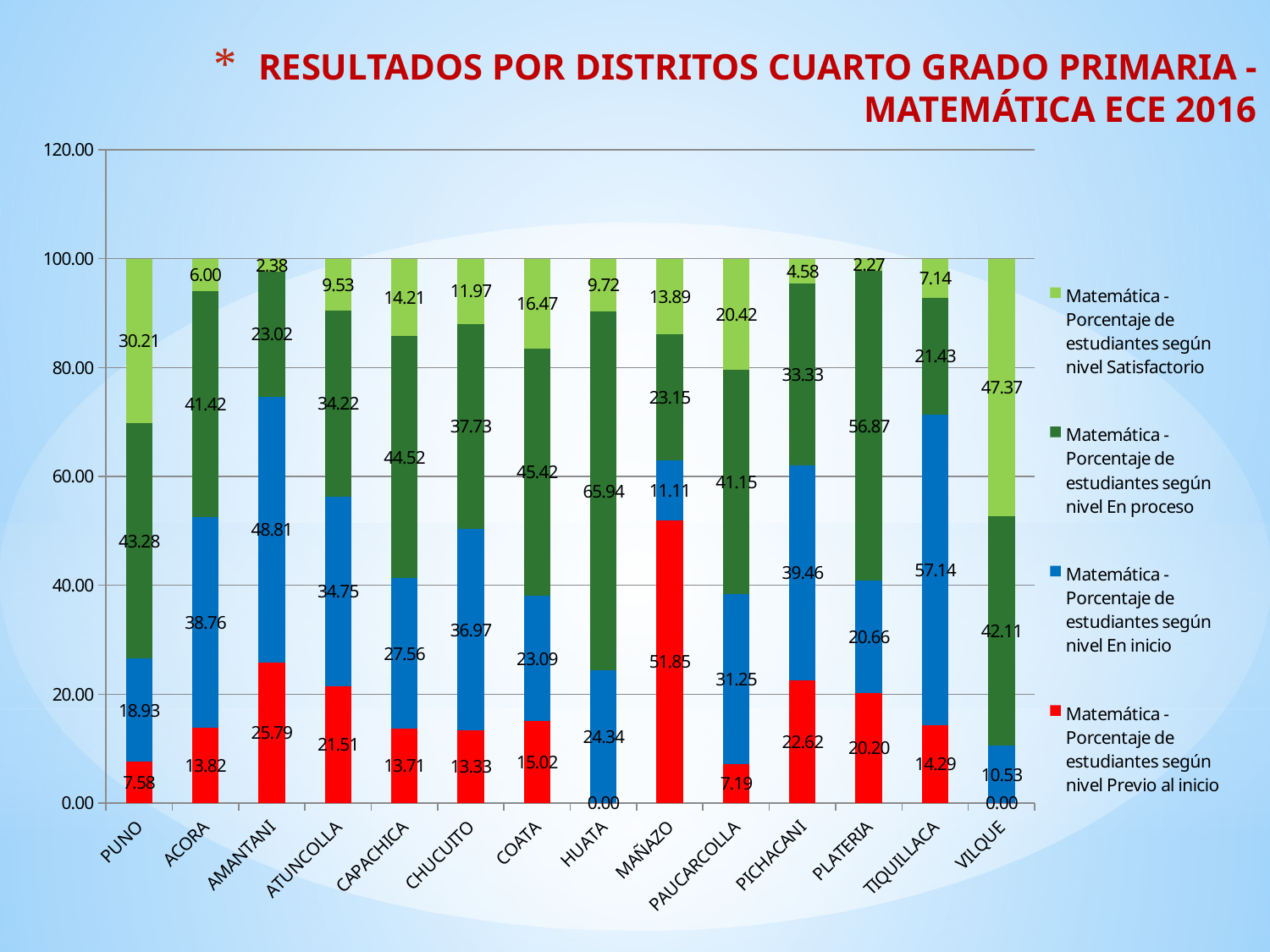
What is the difference between the nivel Satisfactorio values for VILQUE and PUNO? 17.16 What is the value for nivel Satisfactorio in PUNO? 30.21 What type of chart is shown on the slide? Stacked bar chart Which district has the highest value for nivel En proceso? HUATA What is the total of the stacked bar for PUNO? 100.00 Which district has the highest value for nivel Satisfactorio? VILQUE Which district has the lowest value for nivel Satisfactorio? PLATERIA Which is larger: the nivel En inicio value for ACORA or for CAPACHICA? ACORA What is the value for nivel Previo al inicio in MAÑAZO? 51.85 How many districts are shown along the x axis? 14 How many series does the legend list? 4 What is the value for nivel En inicio in TIQUILLACA? 57.14